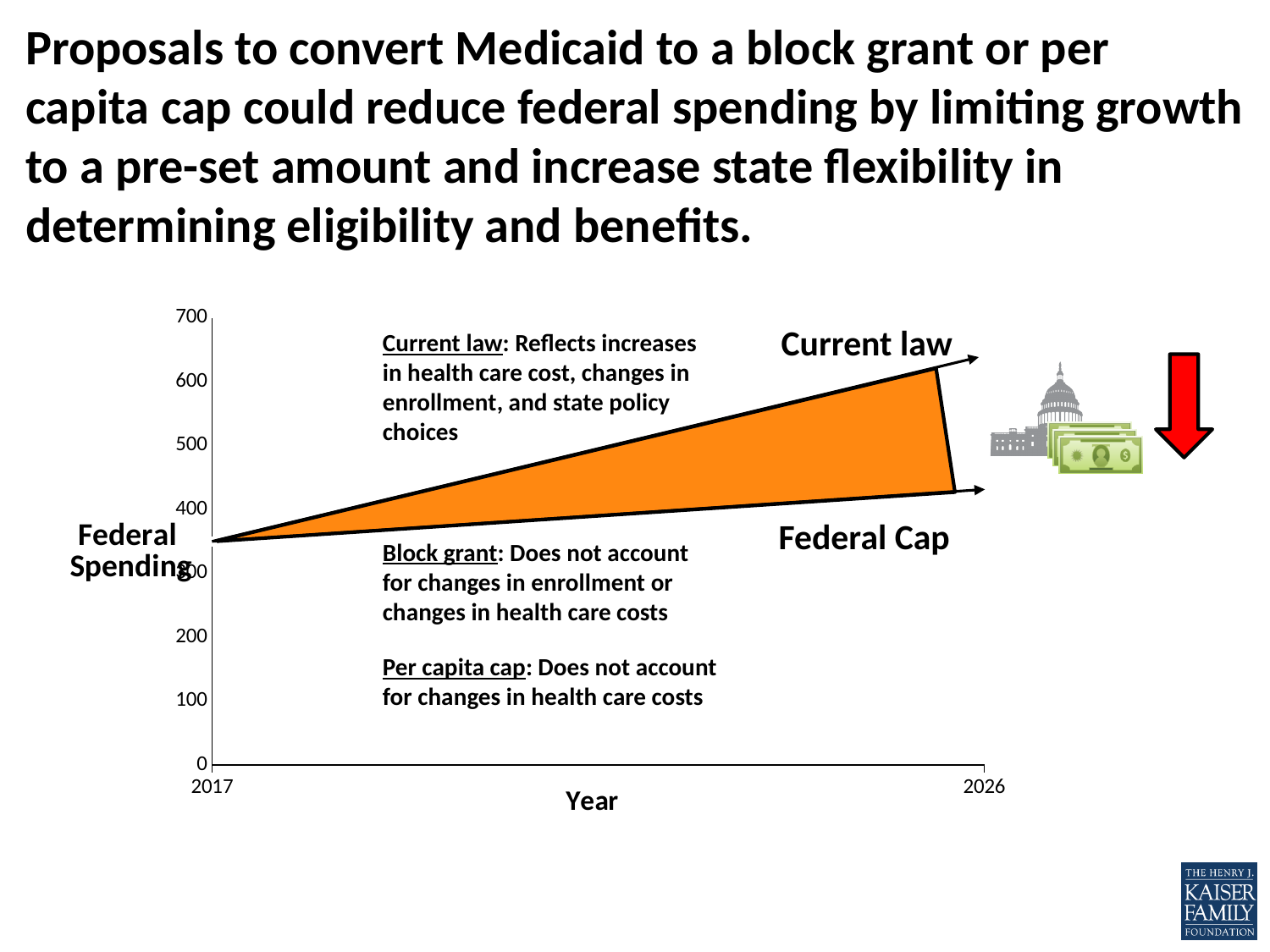
In 2026, which is higher: Current law or Federal Cap? Current law What is the last year shown on the x axis? 2026 What is the label of the x axis? Year What are the two series labelled on the chart? Current law and Federal Cap Is the Federal Cap value in 2026 greater or less than 500? less How many lines (series) are plotted on the chart? 2 Does the Federal Cap line rise or fall from 2017 to 2026? Rise What is the first year shown on the x axis? 2017 What kind of chart is shown on the slide? Line chart Is the Current law value in 2026 greater or less than 500? greater Is the starting value of both lines in 2017 greater or less than 400? less Does the Current law line rise or fall from 2017 to 2026? Rise